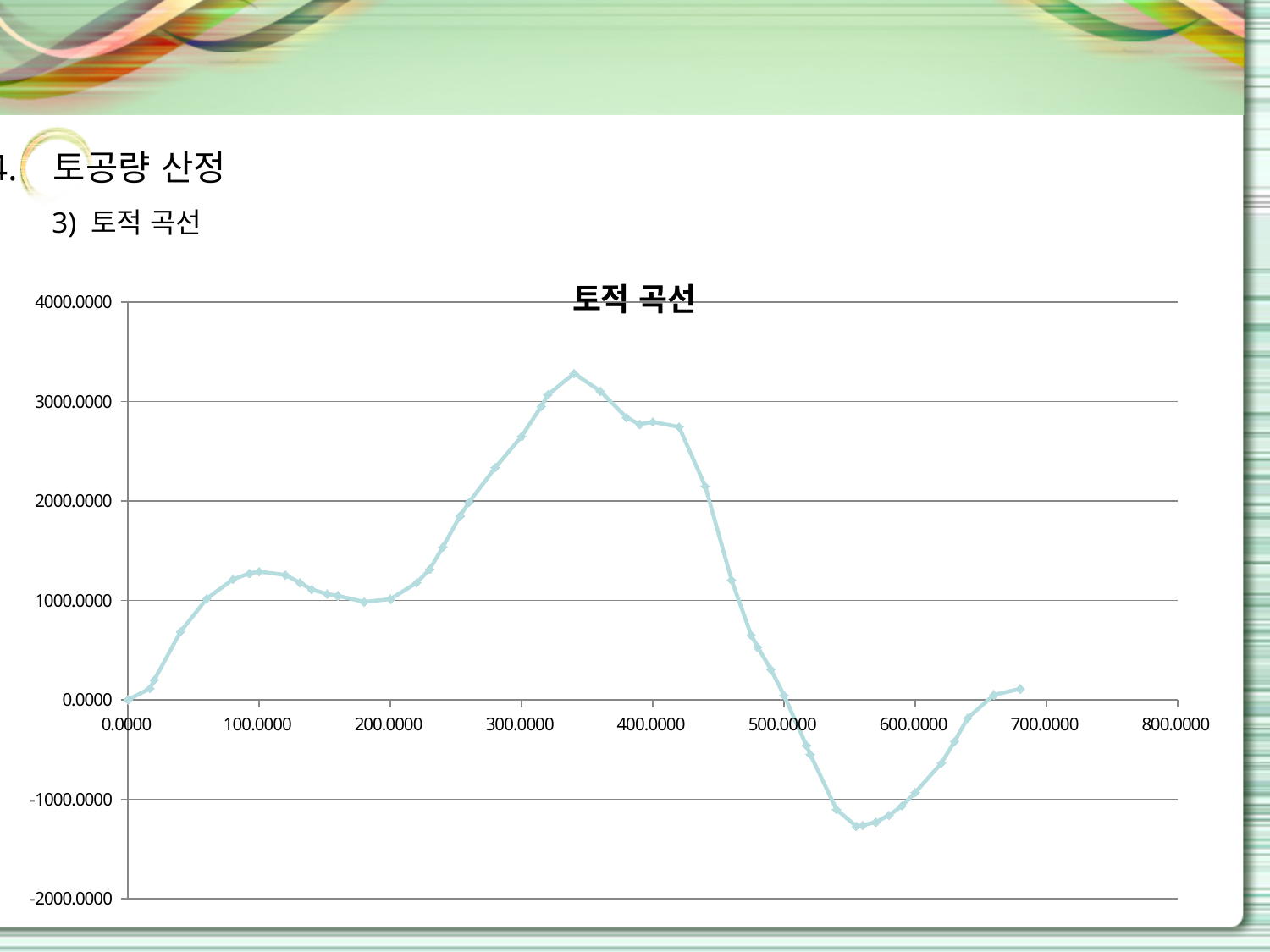
Is the value of the curve at x = 100.0000 greater or less than 1000.0000? greater What is the title of the chart? 토적 곡선 Does the curve rise or fall between x = 400.0000 and x = 500.0000? fall Is the value of the curve at x = 300.0000 greater or less than 2000.0000? greater Which is larger, the value of the curve at x = 300.0000 or at x = 100.0000? 300.0000 What is the value of the curve at x = 0.0000? 0.0000 Does the curve rise or fall between x = 200.0000 and x = 300.0000? rise What kind of chart is shown on the slide? line chart Is the peak value of the curve greater or less than 3000.0000? greater What is the highest tick value shown on the y axis? 4000.0000